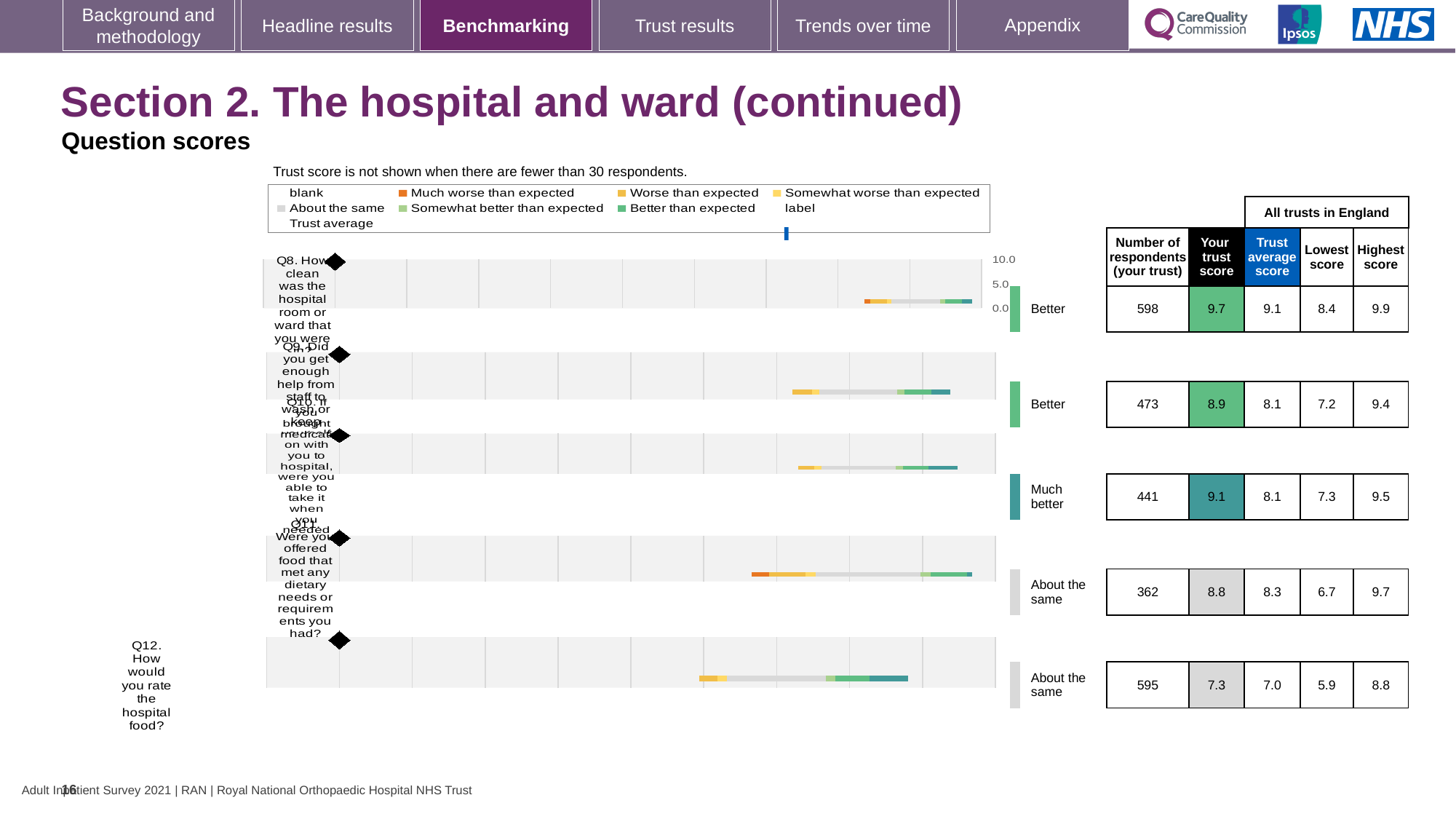
Which question has the lowest 'Your trust score' in the table? Q12 For Q9, which is larger: your trust score or the trust average score? Your trust score What is the lowest score across all trusts in England for Q10? 7.3 For Q8, what is the difference between your trust score and the trust average score? 0.6 What benchmark category is shown next to Q10 in the chart? Much better How many questions (Q8 to Q12) are plotted in the question scores chart? 5 How many respondents from your trust answered Q12 (how would you rate the hospital food)? 595 What kind of chart is used to show the question scores on this slide? bar chart What is the 'Your trust score' for Q8 (how clean was the hospital room or ward)? 9.7 Which question has the highest 'Your trust score' in the table? Q8 What is the trust average score for Q11 (offered food that met dietary needs)? 8.3 Is the trust score for Q12 greater or less than 5.0 on the chart axis? greater